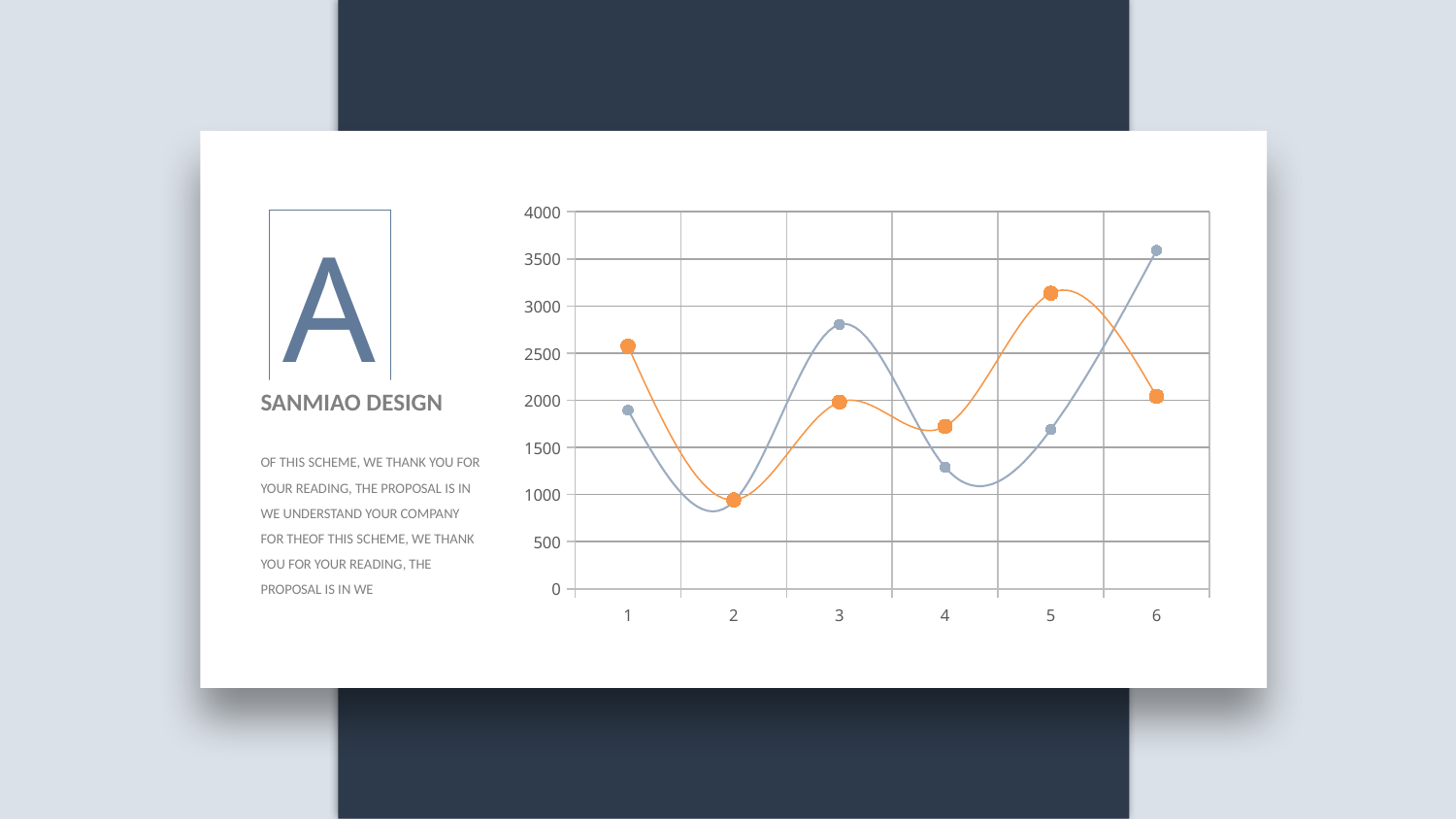
At category 3, which line has the higher value, the blue line or the orange line? the blue line What kind of chart is shown on the slide? line chart How many lines are plotted on the chart? 2 Is the value of the blue line at category 6 greater or less than 3500? greater Is the value of the orange line at category 5 greater or less than 3000? greater At which category does the orange line reach its lowest value? 2 How many points are plotted along the x axis for each line? 6 At category 1, which line has the higher value, the blue line or the orange line? the orange line Is the value of the blue line at category 4 greater or less than 1500? less At which category does the blue line reach its highest value? 6 Does the blue line rise or fall from category 4 to category 6? rise